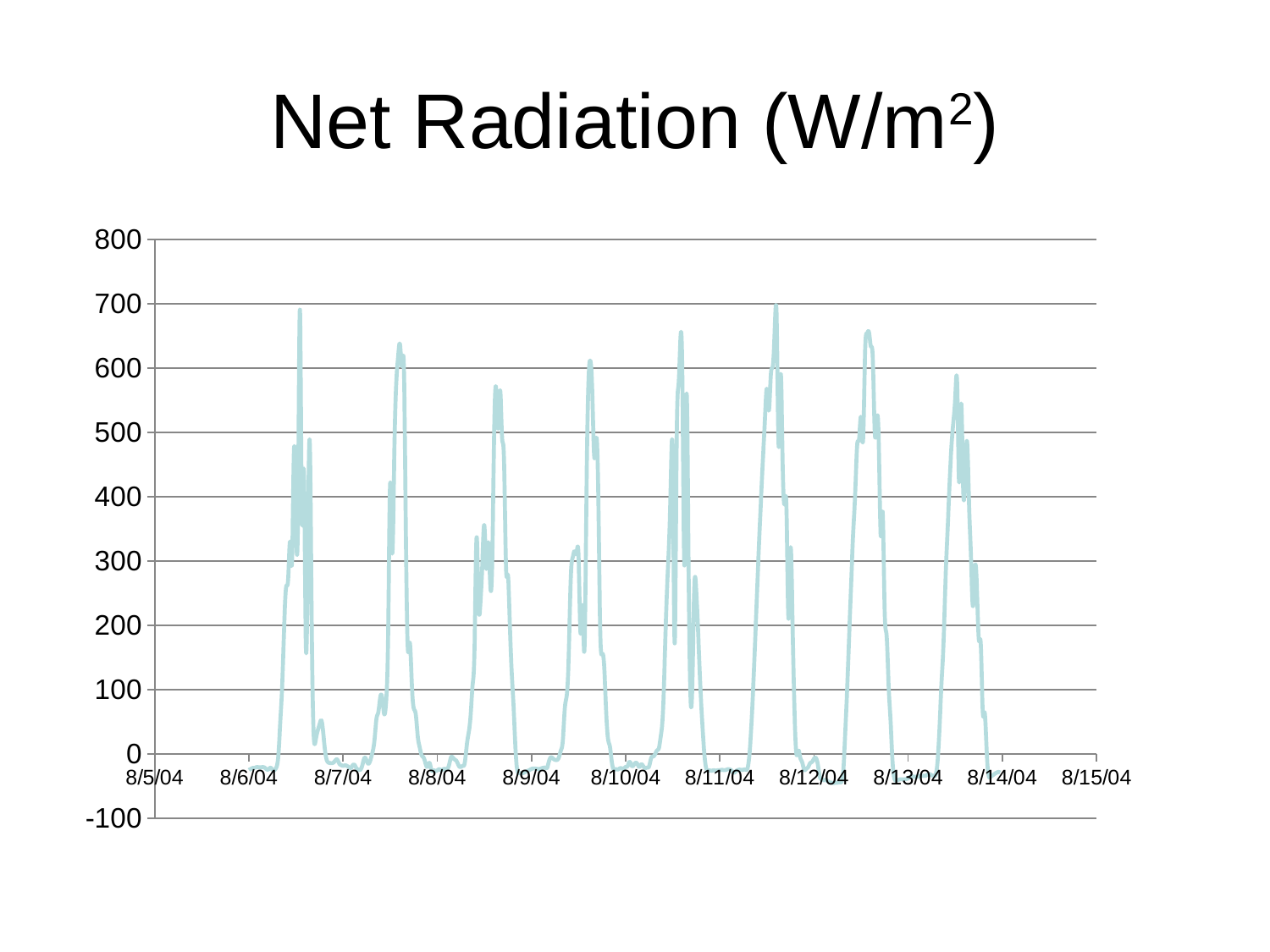
Is the highest peak of the line near 8/10/04 greater or less than 500? greater Is the highest peak of the line near 8/11/04 greater or less than 600? greater Is the highest peak of the line near 8/6/04 greater or less than 600? greater Is the peak near 8/11/04 higher or lower than the peak near 8/8/04? higher How many date labels are shown on the x axis? 11 What is the highest value labelled on the y axis? 800 What is the title of the chart? Net Radiation (W/m2) How many distinct daily peaks does the line show? 8 What kind of chart is shown on the slide? Line chart